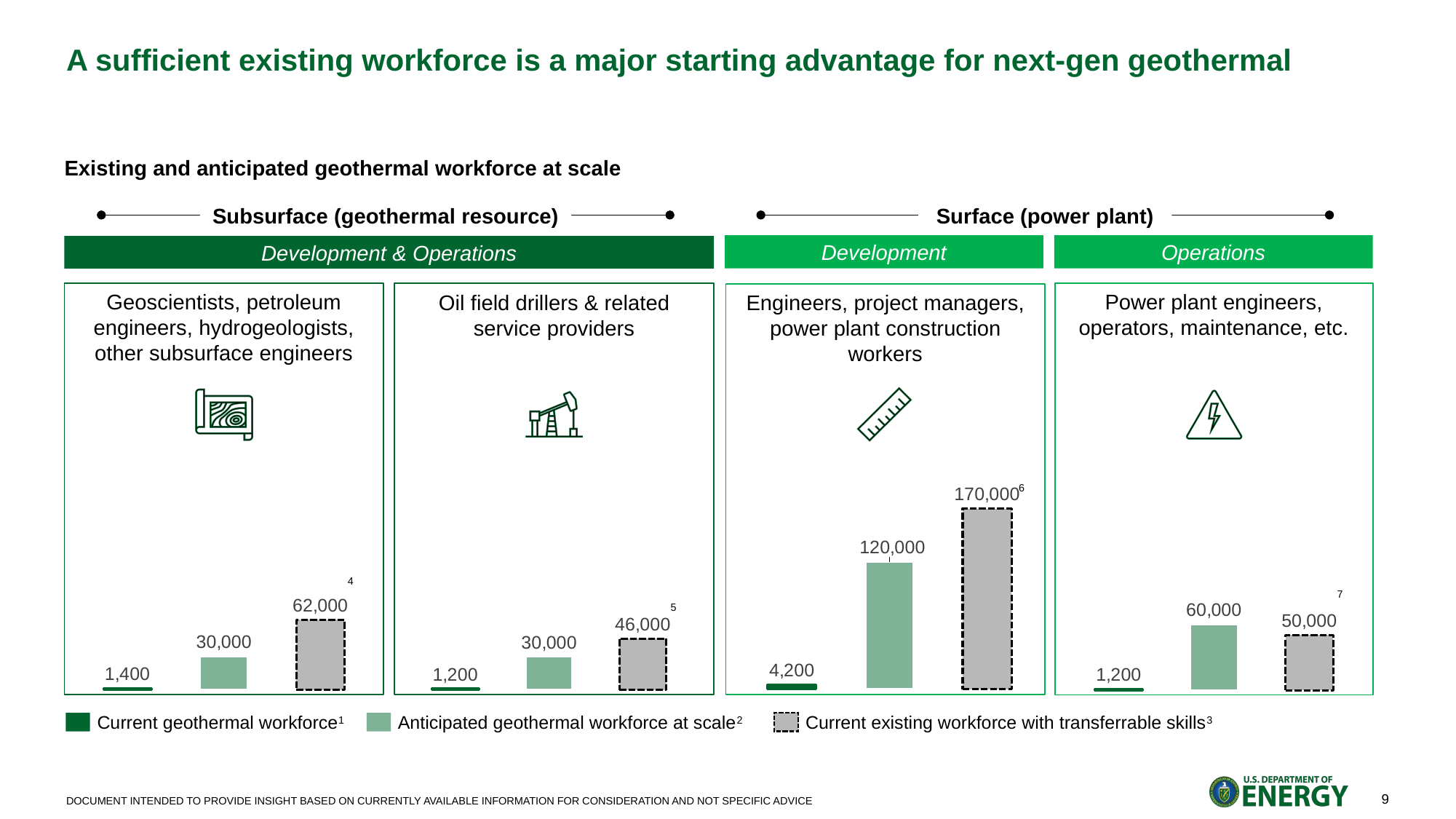
In the 'Oil field drillers & related service providers' chart, what is the current geothermal workforce? 1,200 In the 'Power plant engineers, operators, maintenance, etc.' chart, which series has the lowest value? Current geothermal workforce In the 'Geoscientists, petroleum engineers, hydrogeologists, other subsurface engineers' chart, what is the difference between the current existing workforce with transferrable skills and the anticipated geothermal workforce at scale? 32,000 In the 'Engineers, project managers, power plant construction workers' chart, what is the anticipated geothermal workforce at scale? 120,000 In the 'Engineers, project managers, power plant construction workers' chart, which series has the highest value? Current existing workforce with transferrable skills In the 'Engineers, project managers, power plant construction workers' chart, what is the difference between the current existing workforce with transferrable skills and the anticipated geothermal workforce at scale? 50,000 What kind of chart is used in the 'Oil field drillers & related service providers' panel? Bar chart In the 'Power plant engineers, operators, maintenance, etc.' chart, what is the current existing workforce with transferrable skills? 50,000 How many series does the legend list for the charts on this slide? 3 How many bars are shown in the 'Oil field drillers & related service providers' chart? 3 In the 'Power plant engineers, operators, maintenance, etc.' chart, which is larger: the anticipated geothermal workforce at scale or the current existing workforce with transferrable skills? Anticipated geothermal workforce at scale In the 'Geoscientists, petroleum engineers, hydrogeologists, other subsurface engineers' chart, what is the current existing workforce with transferrable skills? 62,000